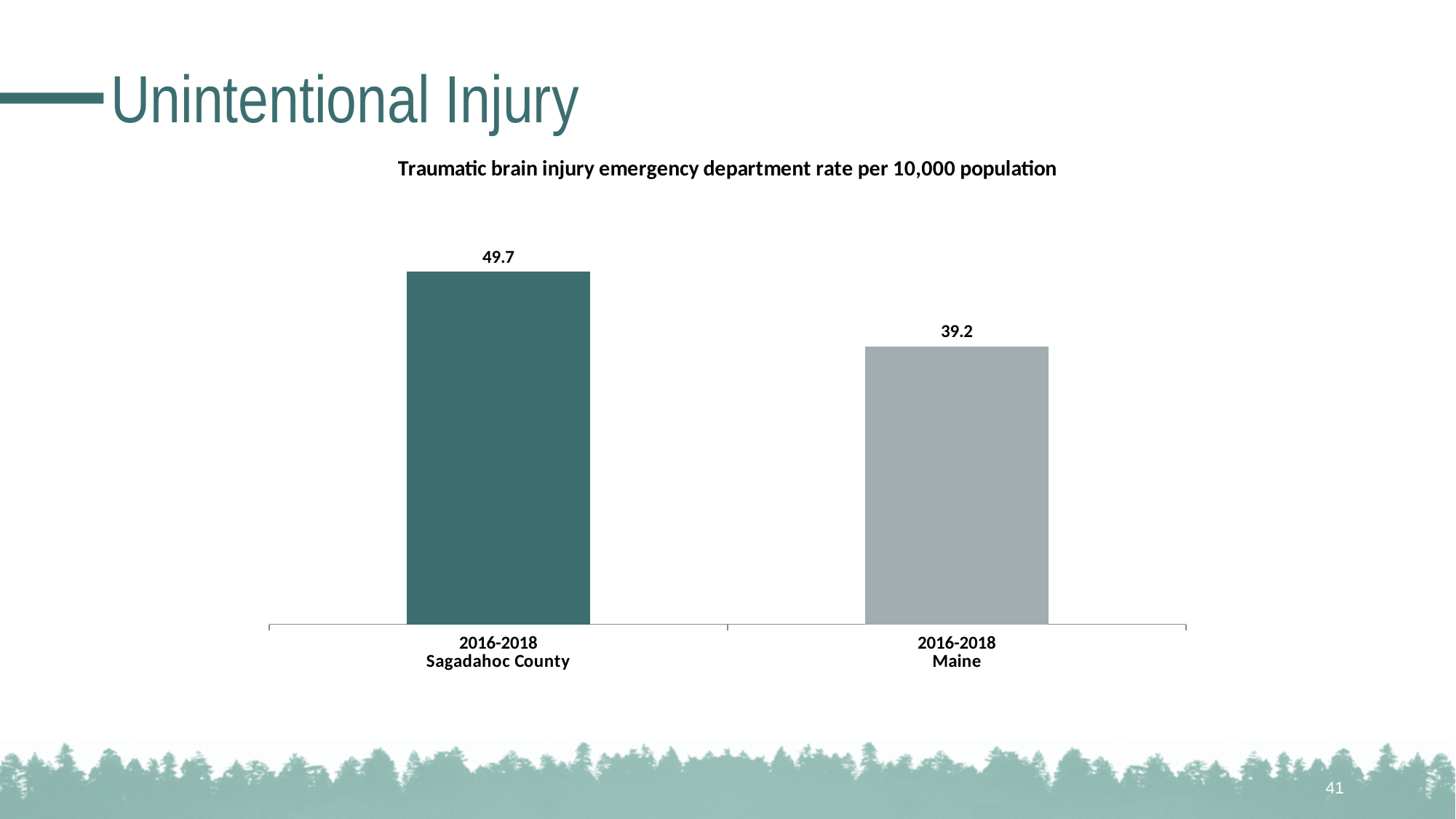
Which category has the lowest traumatic brain injury emergency department rate on the chart? Maine Is the rate for Sagadahoc County larger or smaller than the rate for Maine? larger How many bars are shown on the chart? 2 What time period do both bars on the chart cover? 2016-2018 What is the difference between the Sagadahoc County rate and the Maine rate? 10.5 What is the traumatic brain injury emergency department rate per 10,000 population for Maine in 2016-2018? 39.2 What is the traumatic brain injury emergency department rate per 10,000 population for Sagadahoc County in 2016-2018? 49.7 What kind of chart is shown on the slide? bar chart What is the title of the chart? Traumatic brain injury emergency department rate per 10,000 population Which category has the higher traumatic brain injury emergency department rate, Sagadahoc County or Maine? Sagadahoc County